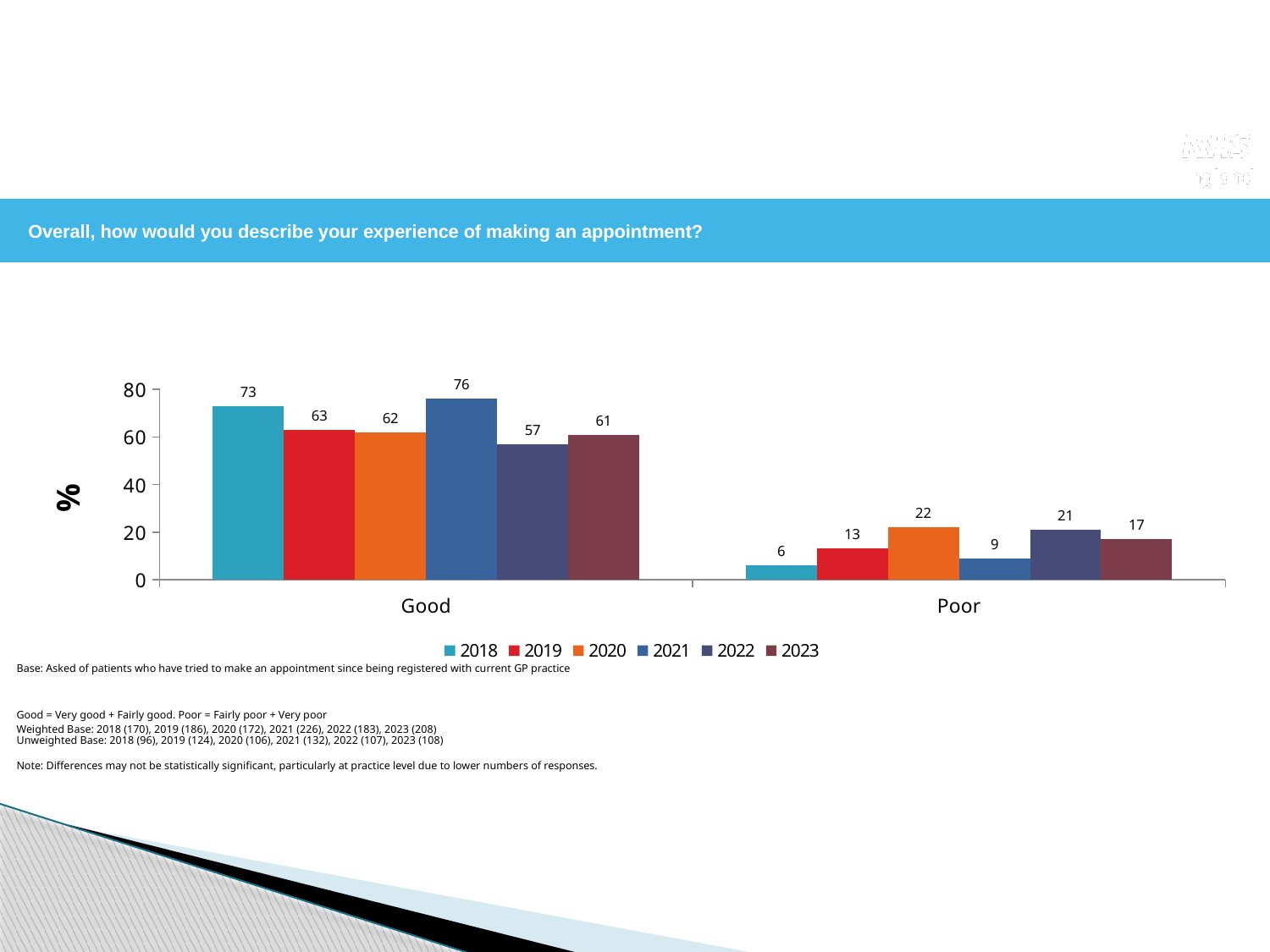
What is the value for 2021 in the Good category? 76 What is the difference between the 2021 and 2022 values in the Good category? 19 What is the value for 2023 in the Good category? 61 How many categories are shown on the x axis? 2 What is the label on the vertical axis? % Which year has the highest value in the Poor category? 2020 Which year has the highest value in the Good category? 2021 What kind of chart is shown on the slide? Bar chart Which is larger: the 2019 value for Poor or the 2021 value for Poor? 2019 Which year has the lowest value in the Poor category? 2018 What is the value for 2018 in the Poor category? 6 How many series does the legend list? 6